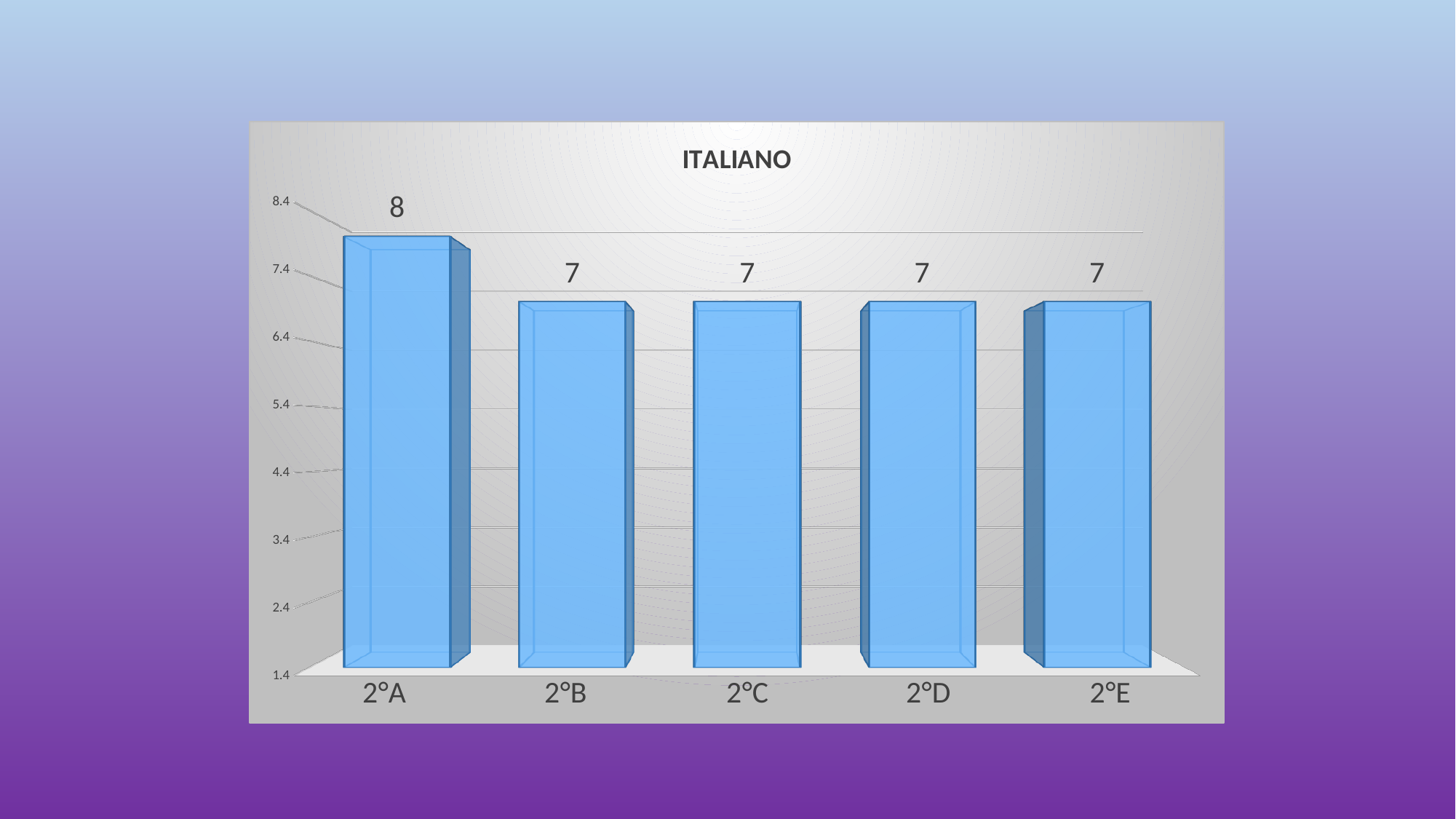
What is the title of the chart? ITALIANO What is the value for 2°A? 8 Which category has the highest value? 2°A Which is larger, the value for 2°A or the value for 2°D? 2°A How many categories have a value of 7? 4 How many categories are shown on the x axis? 5 Is the value for 2°A greater or less than 7.4? greater What is the value for 2°C? 7 Is the value for 2°B greater or less than 6.4? greater What kind of chart is this? bar chart What is the value for 2°E? 7 What is the difference between the values for 2°A and 2°B? 1